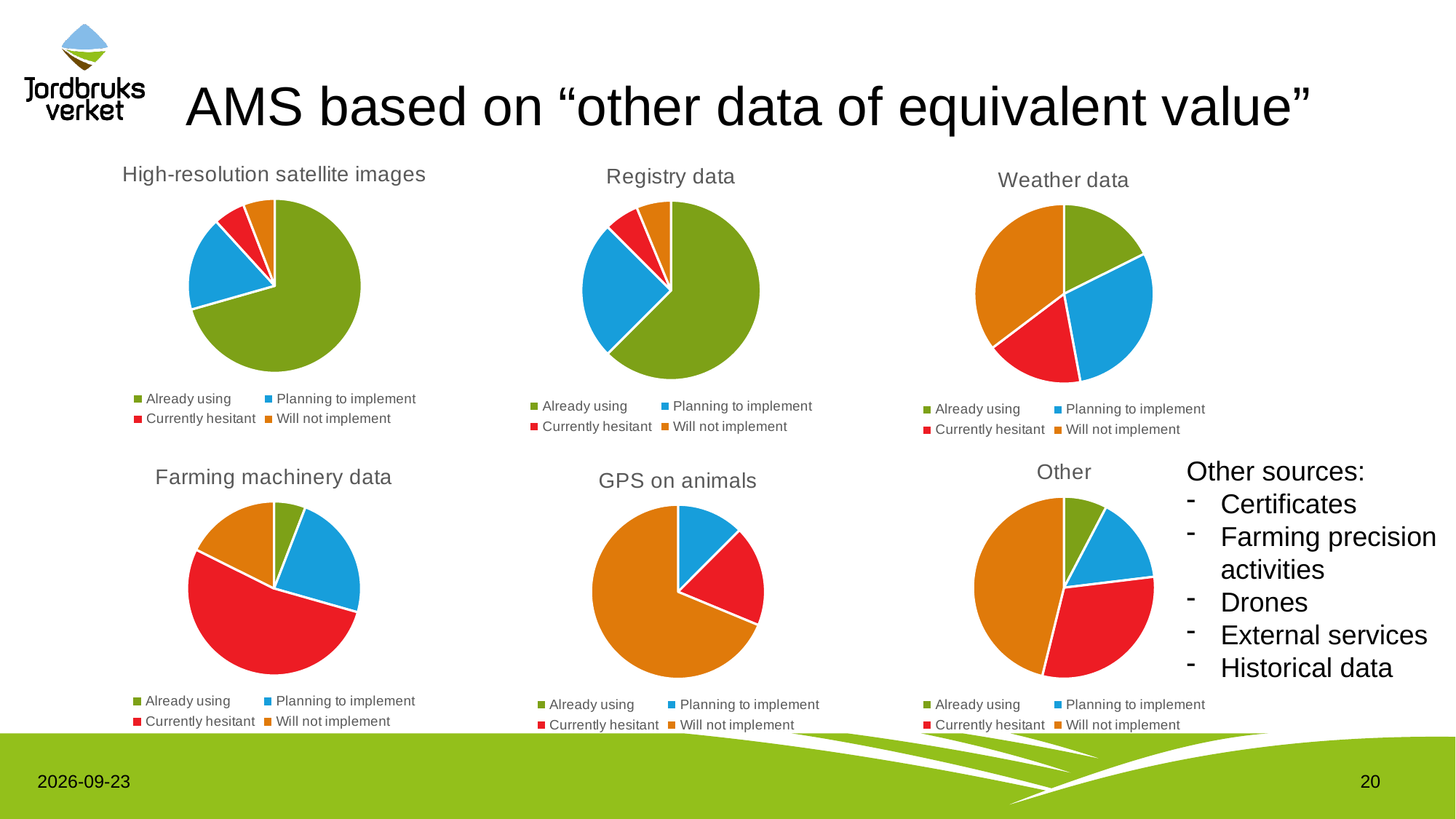
How many categories does the legend of the "Registry data" chart list? 4 In the "Registry data" chart, which category has the largest slice? Already using How many pie charts are shown on the slide? 6 What kind of chart is used for "High-resolution satellite images"? Pie chart In the "Farming machinery data" chart, which category has the smallest slice? Already using In the "Weather data" chart, which category has the largest slice? Will not implement In the "GPS on animals" chart, which slice is larger: "Currently hesitant" or "Planning to implement"? Currently hesitant In the "Other" chart, which category has the smallest slice? Already using In the "GPS on animals" chart, which category has the largest slice? Will not implement In the "Weather data" chart, which colour represents "Will not implement"? Orange